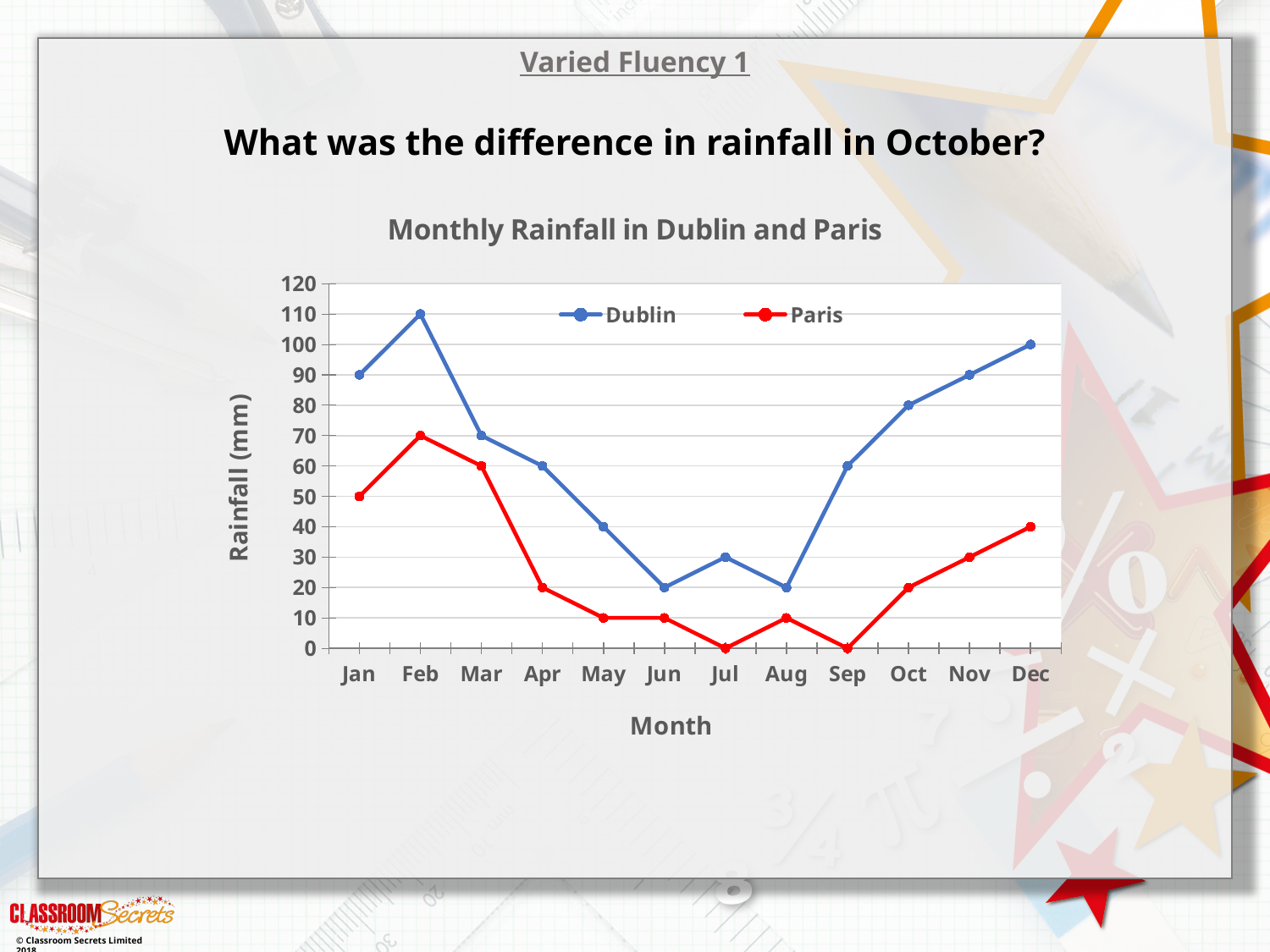
How many months are plotted on the x axis? 12 In which month is Dublin's rainfall highest? Feb What is the rainfall for Dublin in October? 80 How many series does the legend list? 2 Which has higher rainfall in March, Dublin or Paris? Dublin Does Dublin's rainfall rise or fall from September to December? rise What type of chart is shown on the slide? line chart What is the title of the chart? Monthly Rainfall in Dublin and Paris What is the rainfall for Dublin in December? 100 What is the rainfall for Paris in February? 70 What is the rainfall for Paris in October? 20 What is the difference in rainfall between Dublin and Paris in October? 60